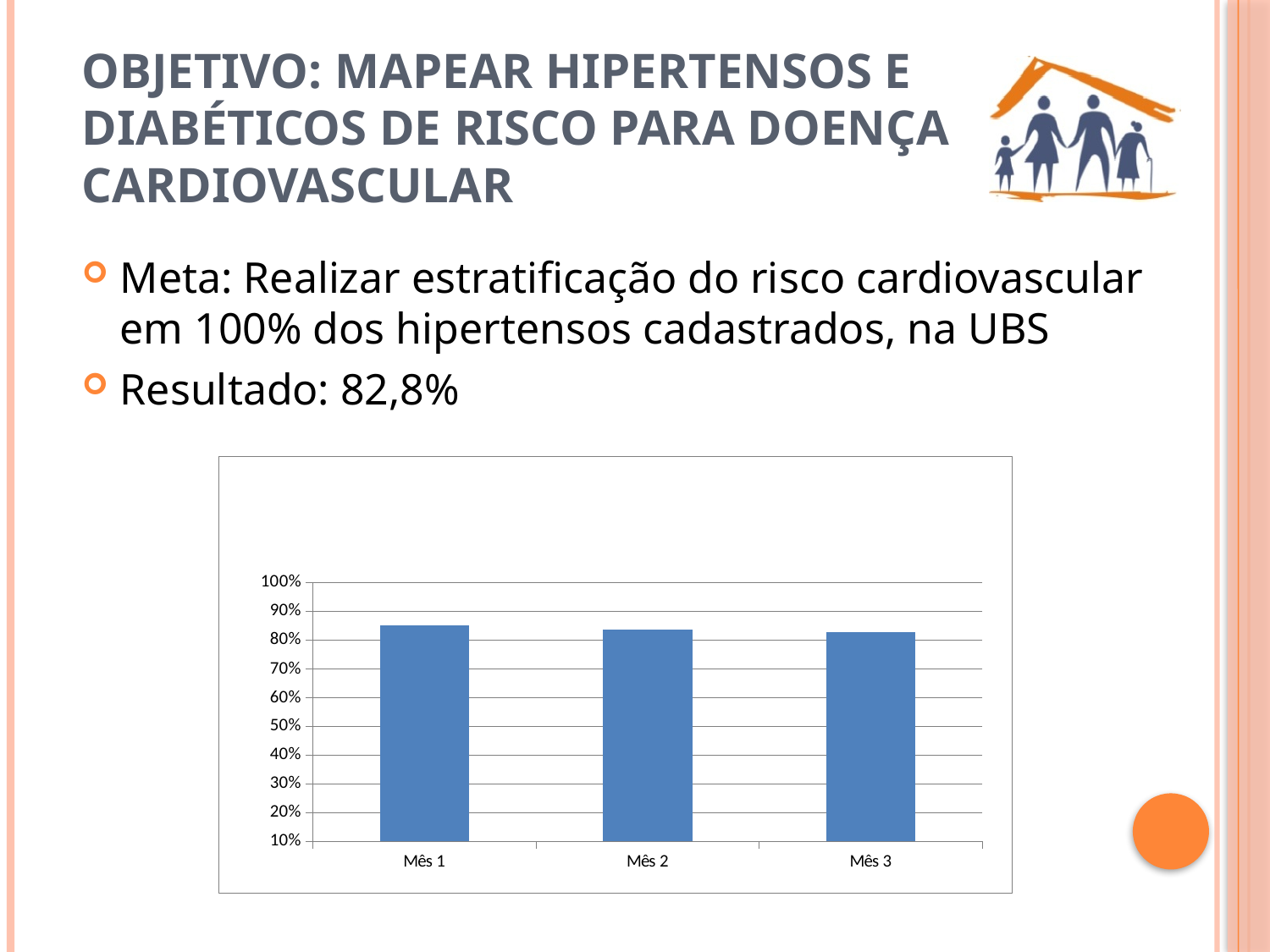
Which is larger, the value for Mês 1 or the value for Mês 3? Mês 1 How many categories are shown on the x axis of the chart? 3 Is the value for Mês 3 greater or less than 70%? greater Do the values rise or fall from Mês 1 to Mês 3? fall What is the lowest tick value shown on the y axis? 10% Is the value for Mês 2 greater or less than 90%? less What kind of chart is shown on the slide? bar chart Is the value for Mês 1 greater or less than 80%? greater What is the label of the first category on the x axis? Mês 1